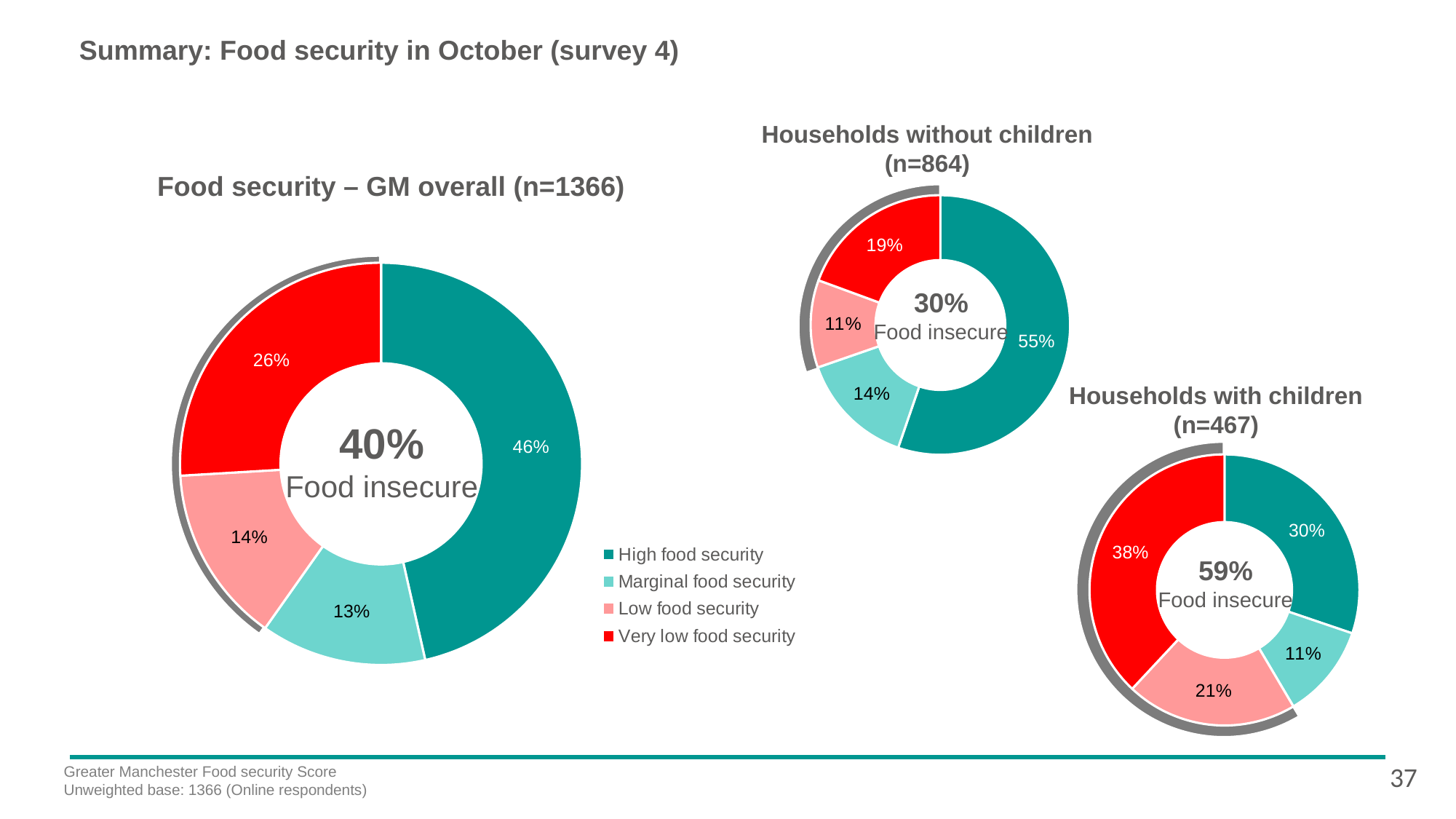
In the 'Food security – GM overall (n=1366)' chart, what percentage is shown for Very low food security? 26% What percentage of households is labelled as food insecure in the centre of the 'Households with children (n=467)' chart? 59% How many categories does the legend list? 4 Which is larger in the 'Households with children (n=467)' chart: the High food security share or the Low food security share? High food security In the 'Households without children (n=864)' chart, which category has the smallest share? Low food security What kind of chart is used for 'Food security – GM overall (n=1366)'? Doughnut (pie) chart In the 'Households with children (n=467)' chart, what percentage is shown for Very low food security? 38% What colour represents Very low food security in the charts? Red In the 'Households with children (n=467)' chart, which category has the largest share? Very low food security In the 'Food security – GM overall (n=1366)' chart, what is the difference between the High food security and Very low food security shares? 20% In the 'Food security – GM overall (n=1366)' chart, what percentage is shown for High food security? 46% In the 'Households without children (n=864)' chart, what percentage is shown for Low food security? 11%